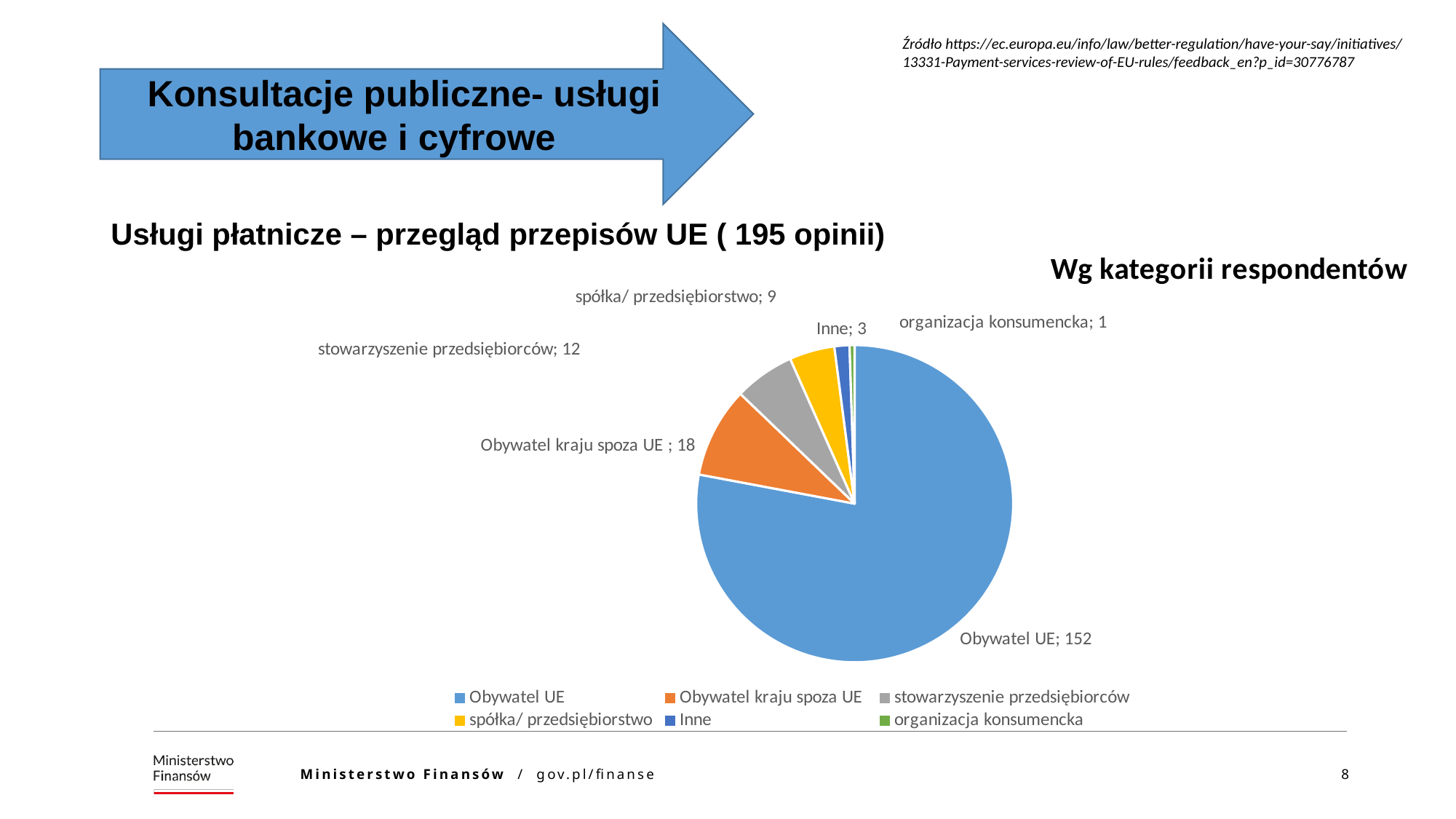
What is the value for 'organizacja konsumencka'? 1 How many respondents are in the 'Obywatel UE' category? 152 What is the value for 'stowarzyszenie przedsiębiorców'? 12 What is the value for 'Obywatel kraju spoza UE'? 18 Which category has the largest slice of the pie? Obywatel UE What is the difference between the values for 'Obywatel UE' and 'Obywatel kraju spoza UE'? 134 How many categories does the pie chart have? 6 Which is larger: 'stowarzyszenie przedsiębiorców' or 'spółka/ przedsiębiorstwo'? stowarzyszenie przedsiębiorców What is the value for 'spółka/ przedsiębiorstwo'? 9 What kind of chart is shown on the slide? pie chart What is the total of all the slices in the pie chart? 195 Which category has the smallest slice of the pie? organizacja konsumencka